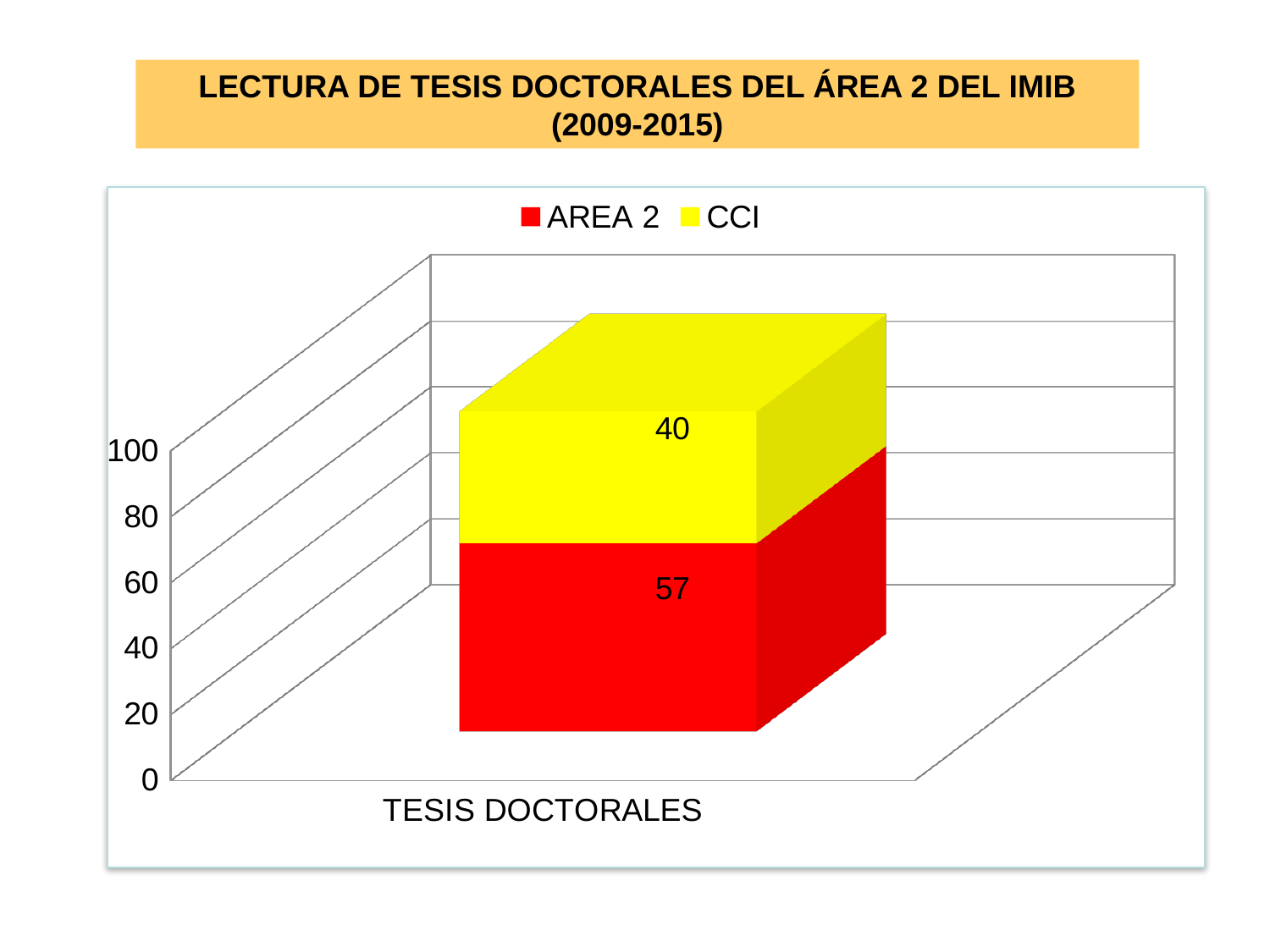
How many series does the legend list? 2 What is the value for CCI in the TESIS DOCTORALES bar? 40 What is the category label on the x axis? TESIS DOCTORALES Is the total of the stacked bar greater or less than 80? greater Which series has the smallest value in the chart? CCI What is the value for AREA 2 in the TESIS DOCTORALES bar? 57 What colour represents the CCI series? Yellow Which series has the larger value, AREA 2 or CCI? AREA 2 What is the total of the stacked TESIS DOCTORALES bar? 97 What kind of chart is shown on the slide? Stacked bar chart What is the difference between the AREA 2 value and the CCI value? 17 How many categories are shown on the x axis? 1